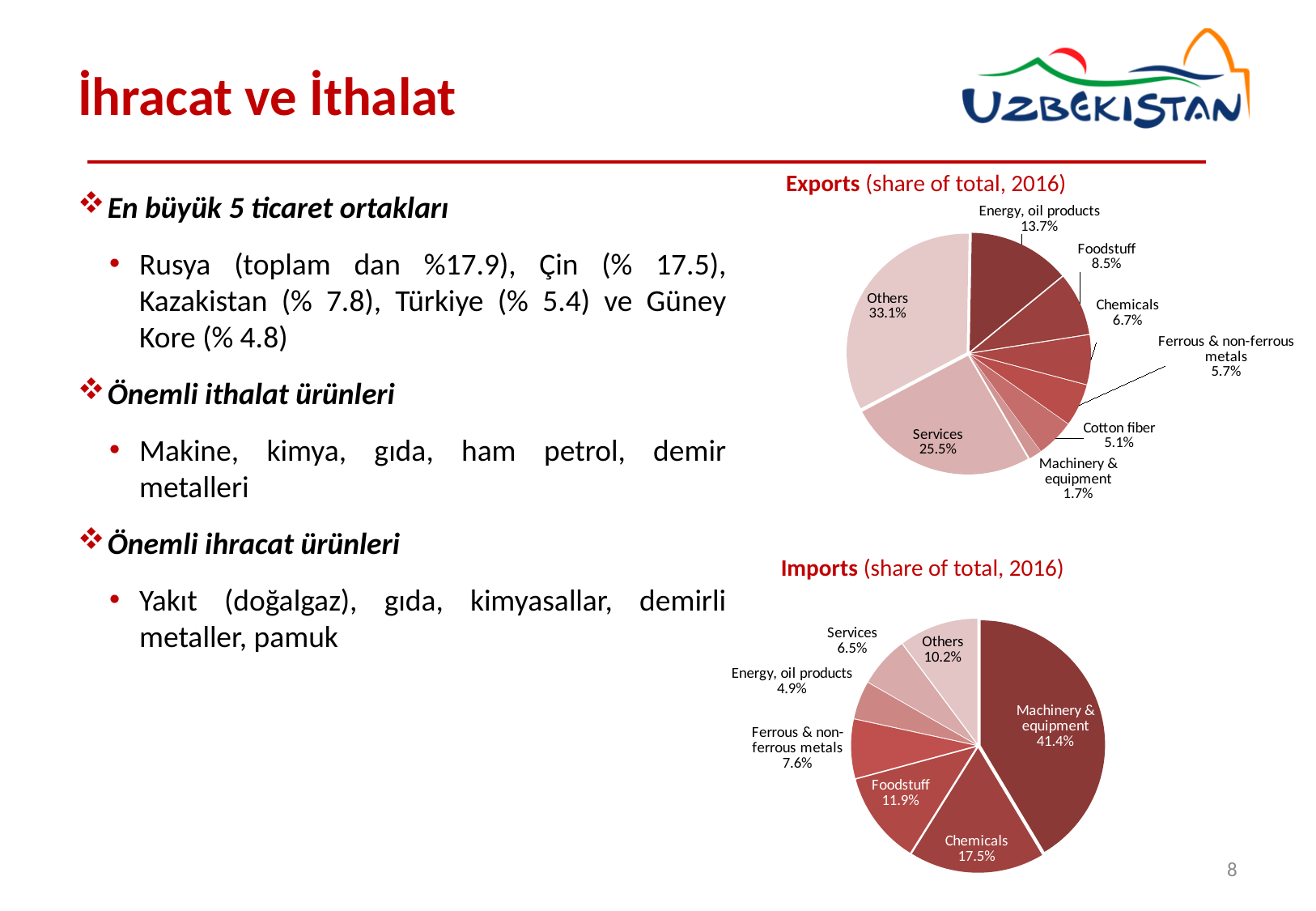
What type of chart is the Imports (share of total, 2016) chart? Pie chart In the Exports (share of total, 2016) chart, what share do Services have? 25.5% In the Exports (share of total, 2016) chart, what is the difference between the shares of Energy, oil products and Foodstuff? 5.2% In the Exports (share of total, 2016) chart, how many slices does the pie have? 8 In the Imports (share of total, 2016) chart, which category has the smallest share? Energy, oil products In the Imports (share of total, 2016) chart, how many slices does the pie have? 7 In the Exports (share of total, 2016) chart, which category has the largest share? Others In the Exports (share of total, 2016) chart, what share does Cotton fiber have? 5.1% In the Exports (share of total, 2016) chart, which category has the smallest share? Machinery & equipment In the Imports (share of total, 2016) chart, what share does Machinery & equipment have? 41.4% In the Imports (share of total, 2016) chart, which is larger, Chemicals or Foodstuff? Chemicals In the Imports (share of total, 2016) chart, what share do Ferrous & non-ferrous metals have? 7.6%